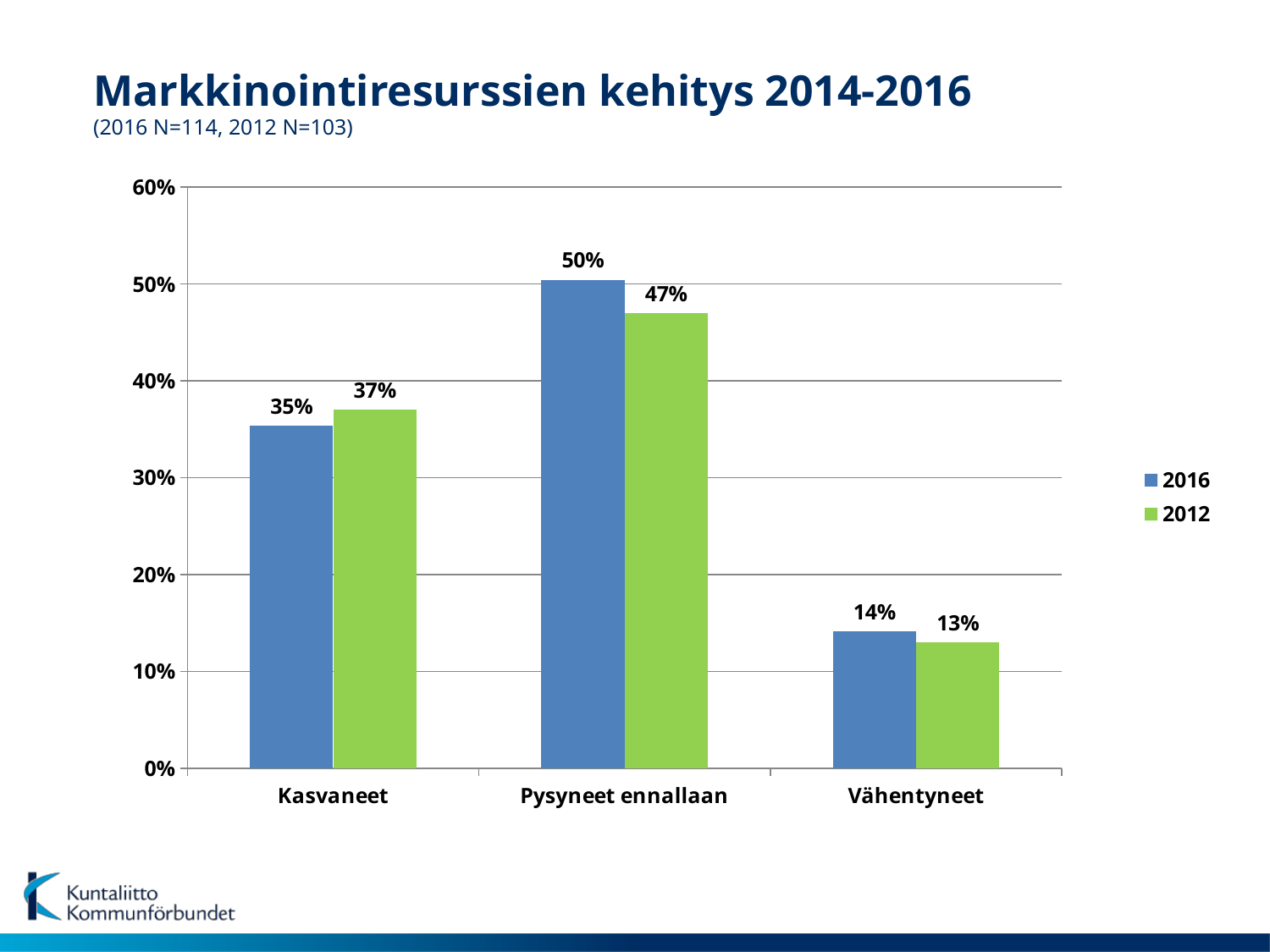
What is the value for Vähentyneet in the 2016 series? 14% How many series does the legend list? 2 How many categories are shown on the x axis? 3 What is the value for Kasvaneet in the 2016 series? 35% Which category has the lowest value in the 2012 series? Vähentyneet Is the value for Vähentyneet in the 2012 series greater or less than 20%? less What kind of chart is shown on the slide? bar chart For Kasvaneet, which series has the larger value, 2016 or 2012? 2012 What is the value for Pysyneet ennallaan in the 2012 series? 47% Which category has the highest value in the 2016 series? Pysyneet ennallaan What is the difference between the 2016 and 2012 values for Pysyneet ennallaan? 3% What is the title of the chart? Markkinointiresurssien kehitys 2014-2016